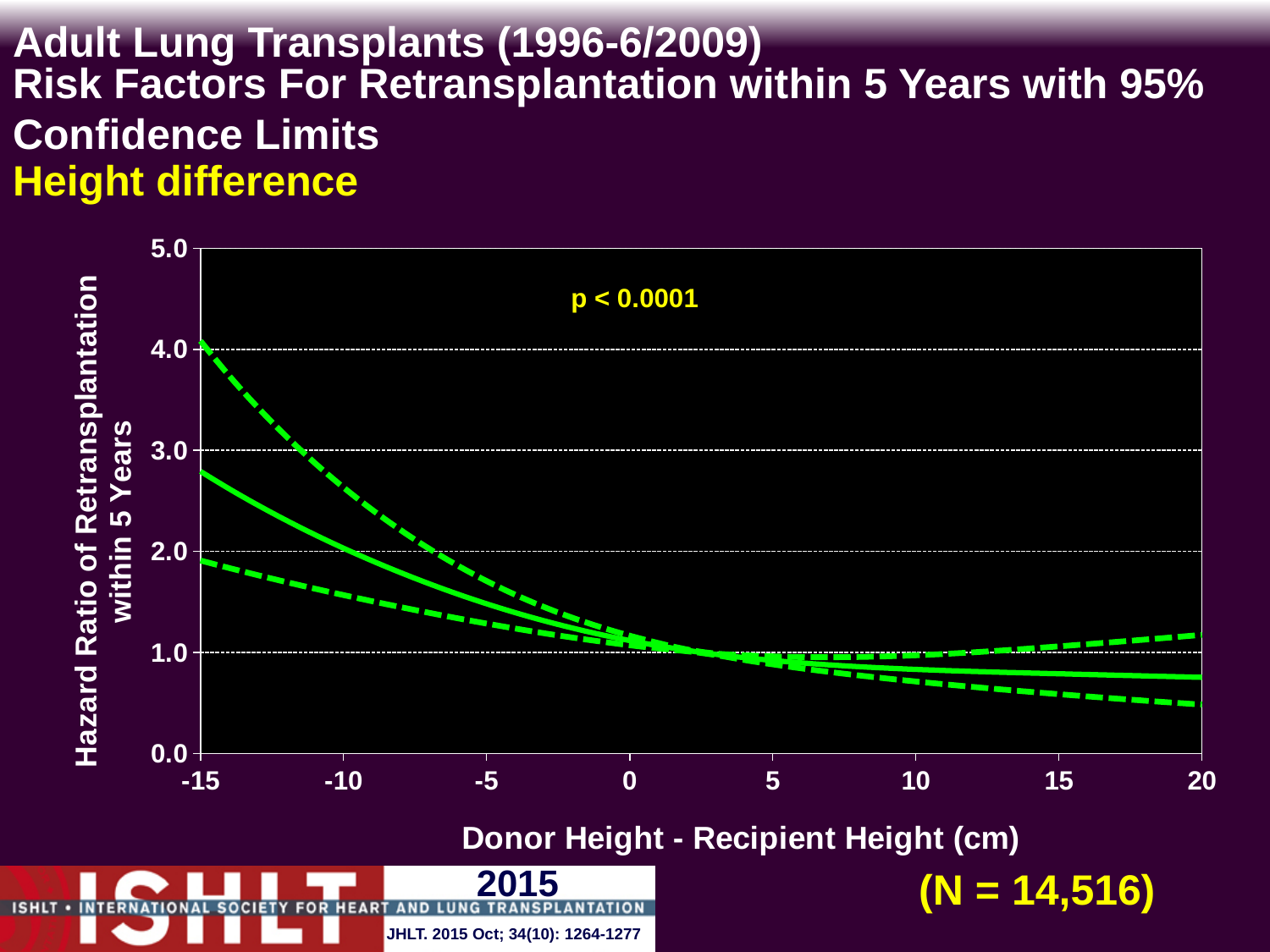
Is the upper confidence limit at a height difference of -10 cm greater or less than 2.0? greater What p-value is printed on the chart? p < 0.0001 Is the lower confidence limit at a height difference of 20 cm greater or less than 1.0? less At which end of the x axis, -15 cm or 20 cm, is the hazard ratio (solid line) higher? -15 cm Is the hazard ratio (solid line) at a height difference of -15 cm greater or less than 2.0? greater At which height difference on the x axis does the solid hazard ratio line reach its highest value? -15 How many lines are plotted on the chart? 3 What is the label of the x axis? Donor Height - Recipient Height (cm) What kind of chart is shown on the slide? line chart Does the solid hazard ratio line rise or fall as the donor-recipient height difference increases from -15 to 20 cm? fall